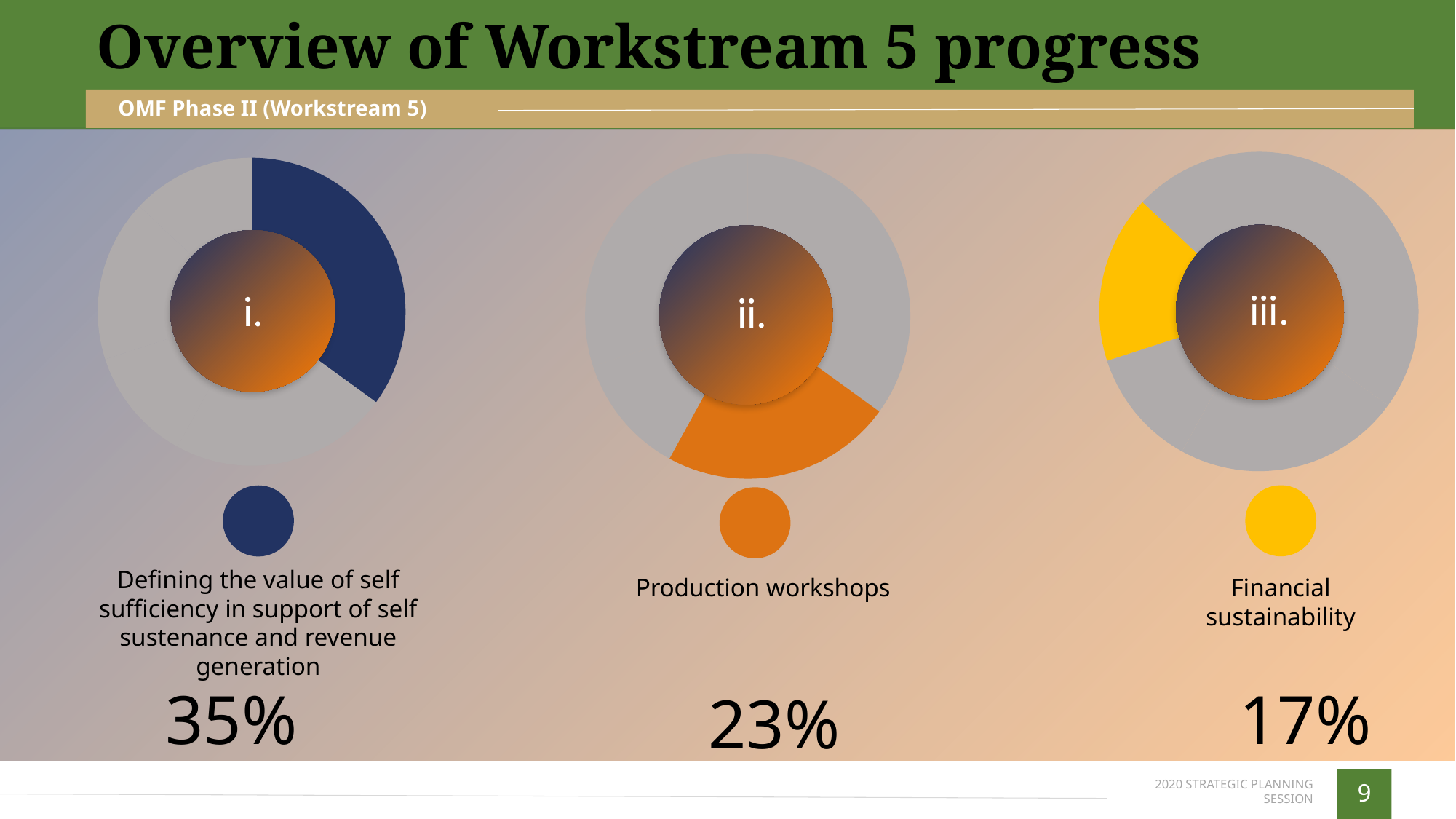
Which of the three workstream items shows the lowest progress percentage? Financial sustainability What is the difference in progress between the first chart (35%) and Production workshops? 12% What colour is the filled segment in the Financial sustainability chart? Yellow What is the difference in progress between Production workshops and Financial sustainability? 6% How many progress charts are shown on the slide? 3 What kind of chart is used to show the progress of each workstream item? Doughnut chart What progress percentage is shown for Production workshops? 23% What progress percentage is shown for Financial sustainability? 17% What colour is the filled segment in the Production workshops chart? Orange What progress percentage is shown for the chart labelled 'Defining the value of self sufficiency in support of self sustenance and revenue generation'? 35% Which of the three workstream items shows the highest progress percentage? Defining the value of self sufficiency in support of self sustenance and revenue generation Which has a higher progress percentage, Production workshops or Financial sustainability? Production workshops